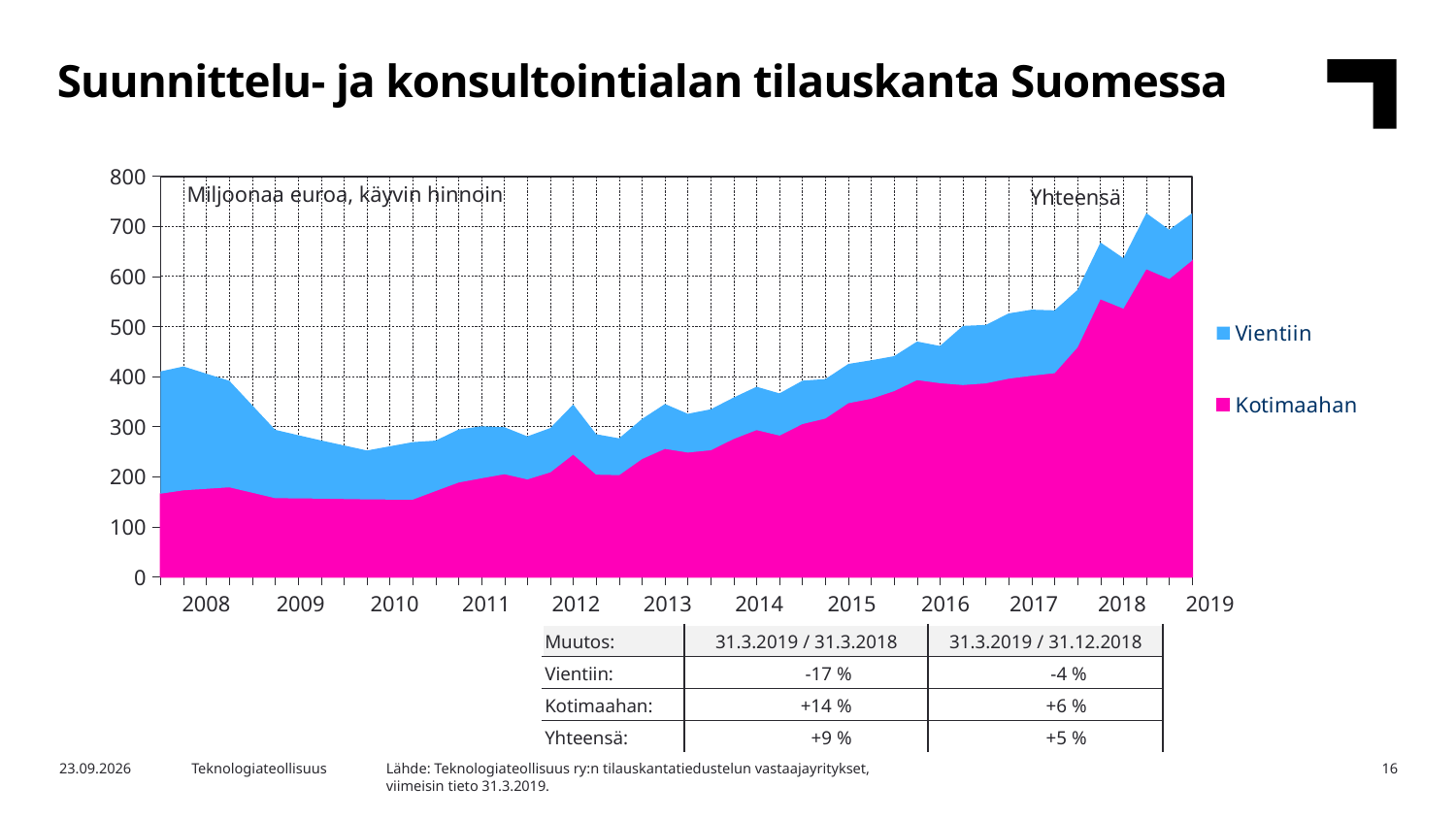
How many series does the chart legend list? 2 Is the total (Yhteensä) value at the end of the series in 2019 greater or less than 600? greater Which series is larger at the end of the series in 2019, Vientiin or Kotimaahan? Kotimaahan According to the table below the chart, what is the change in Kotimaahan for 31.3.2019 / 31.3.2018? +14 % Is the total (Yhteensä) value around 2010 greater or less than 400? less Is the Kotimaahan value at the start of 2008 greater or less than 200? less What kind of chart is shown on the slide? Stacked area chart What are the two series named in the chart legend? Vientiin and Kotimaahan Does the Kotimaahan series generally rise or fall from 2008 to 2019? Rise How many year labels are shown on the x axis? 12 What unit label is printed inside the chart area at the top left? Miljoonaa euroa, käyvin hinnoin